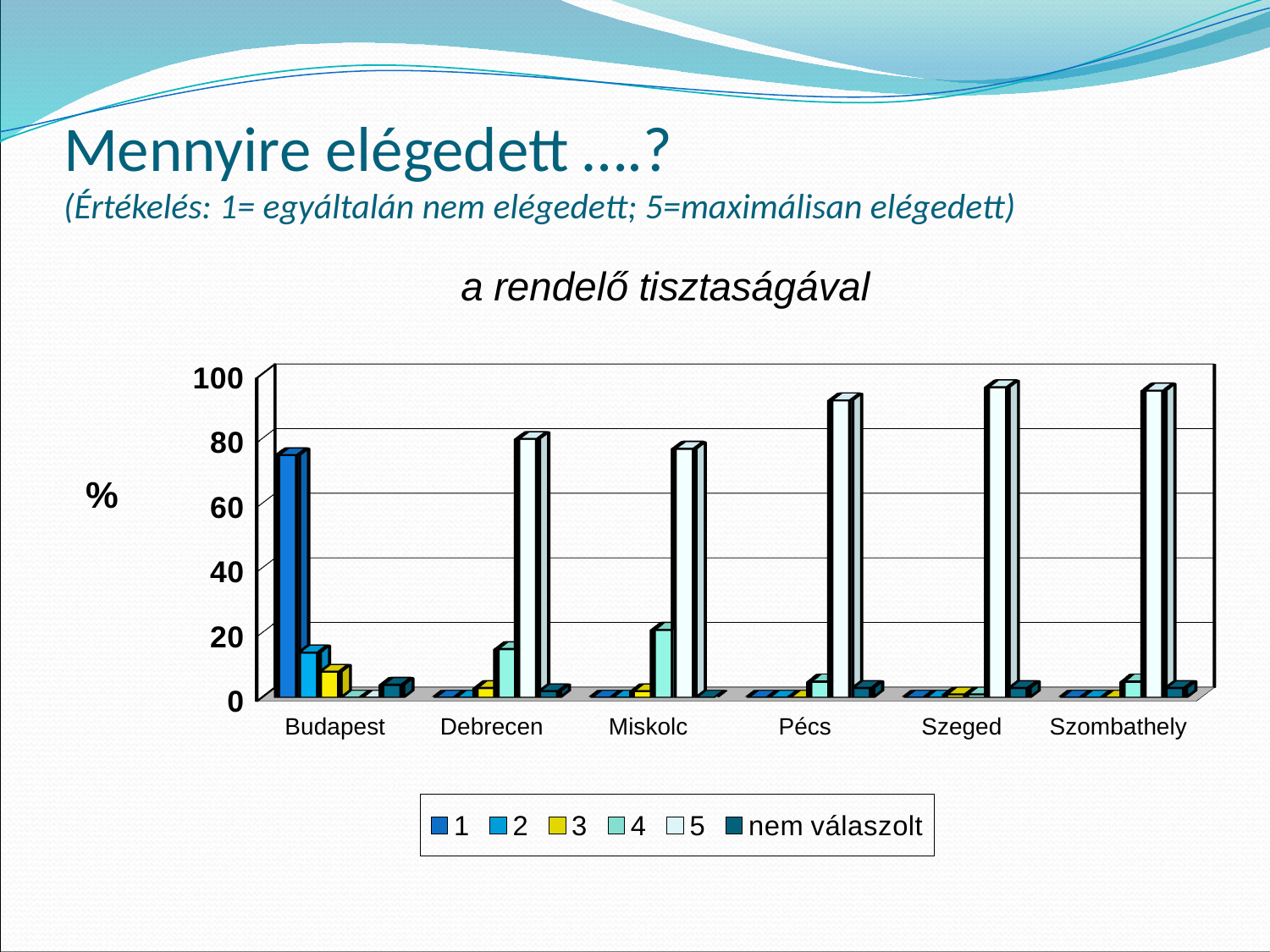
Is the value for series 5 in Pécs greater or less than 80? greater In Budapest, which is larger: the value for series 1 or the value for series 2? series 1 What label is shown on the vertical axis of the chart? % Is the value for series 1 in Budapest greater or less than 60? greater How many series does the legend list? 6 What is the title of the chart? a rendelő tisztaságával Which is larger: the value for series 5 in Debrecen or the value for series 5 in Pécs? Pécs Is the value for series 4 in Miskolc greater or less than 40? less Which city has the highest value for series 1? Budapest What kind of chart is shown on the slide? bar chart How many cities are shown on the x axis of the chart? 6